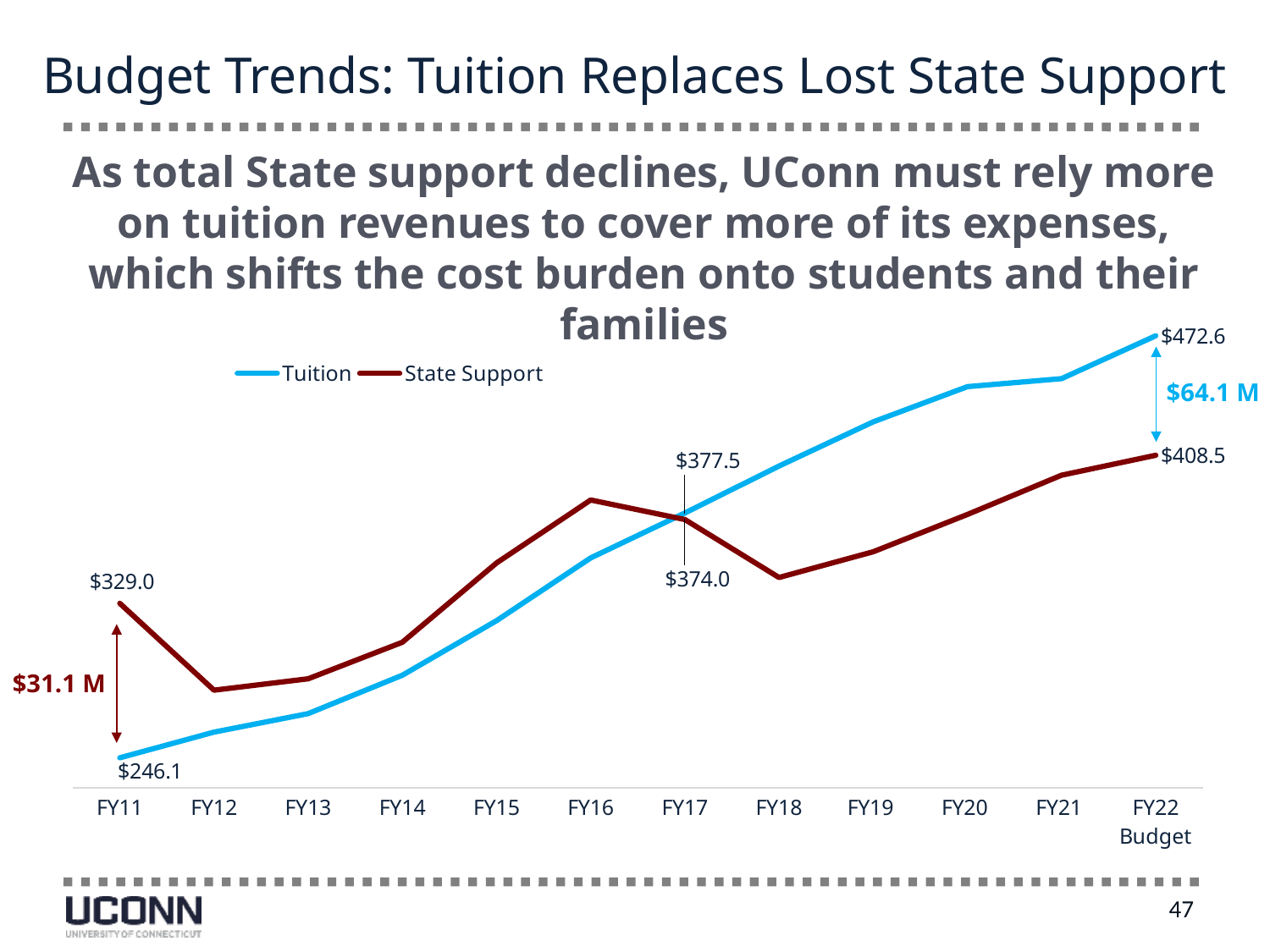
Which is larger in FY11, Tuition or State Support? State Support What kind of chart is shown on the slide? Line chart What is the State Support value for FY17? $374.0 What is the State Support value for FY22 Budget? $408.5 Which is larger in FY22 Budget, Tuition or State Support? Tuition What is the difference between Tuition and State Support in FY22 Budget? $64.1 M What is the Tuition value for FY22 Budget? $472.6 What is the State Support value for FY11? $329.0 Does the Tuition line generally rise or fall from FY11 to FY22 Budget? Rise How many fiscal years are shown on the x axis? 12 How many series does the legend list? 2 What is the Tuition value for FY11? $246.1